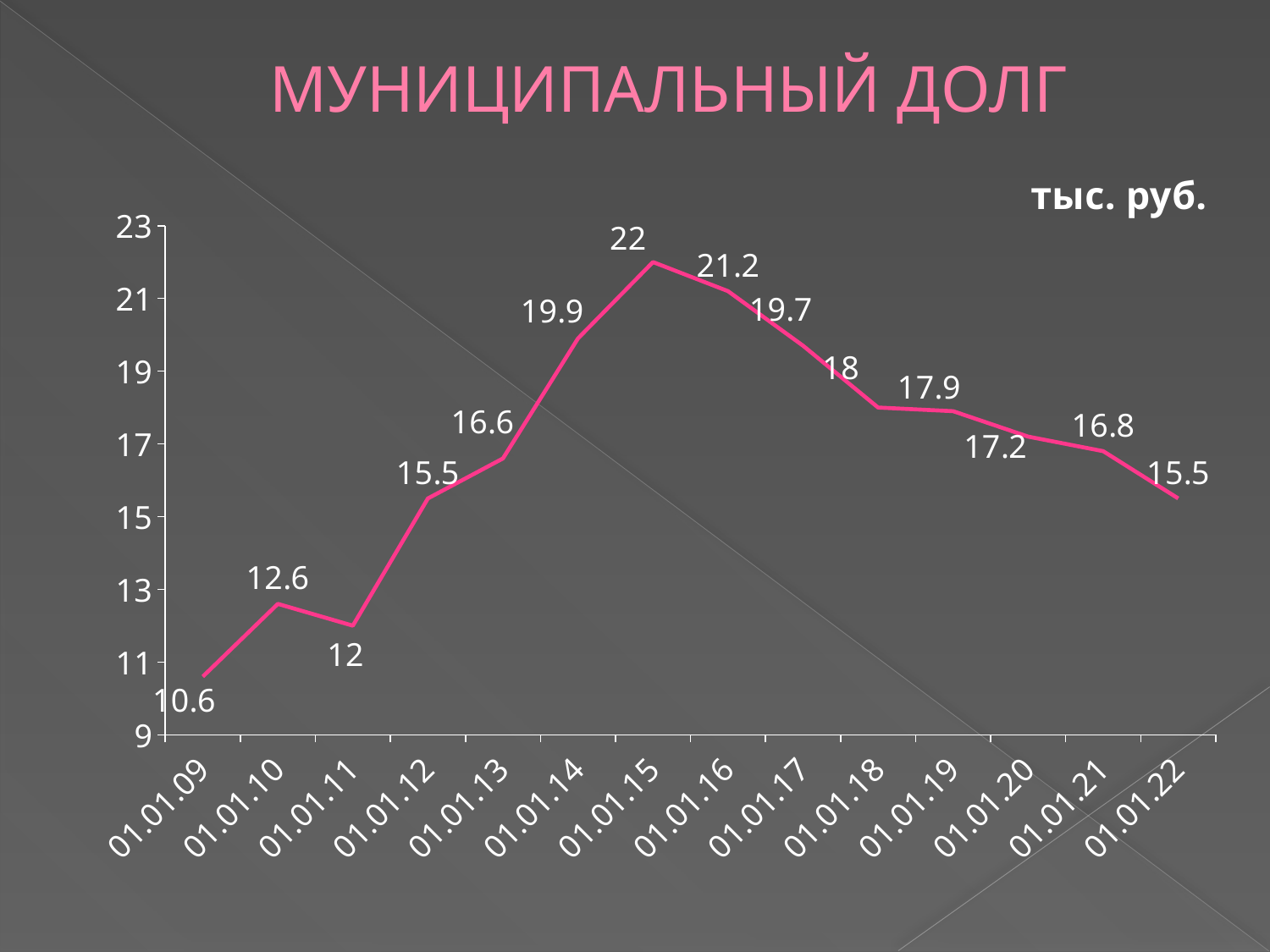
What is the difference between the values for 01.01.15 and 01.01.22? 6.5 What unit is shown above the chart? тыс. руб. What is the value for 01.01.09? 10.6 How many data points are plotted on the chart? 14 Which date has the lowest value? 01.01.09 What is the value for 01.01.15? 22 What is the value for 01.01.19? 17.9 What is the difference between the values for 01.01.10 and 01.01.11? 0.6 Which date has the highest value? 01.01.15 Do the values rise or fall from 01.01.15 to 01.01.22? fall What kind of chart is shown on the slide? line chart Which is larger, the value for 01.01.14 or the value for 01.01.17? 01.01.14